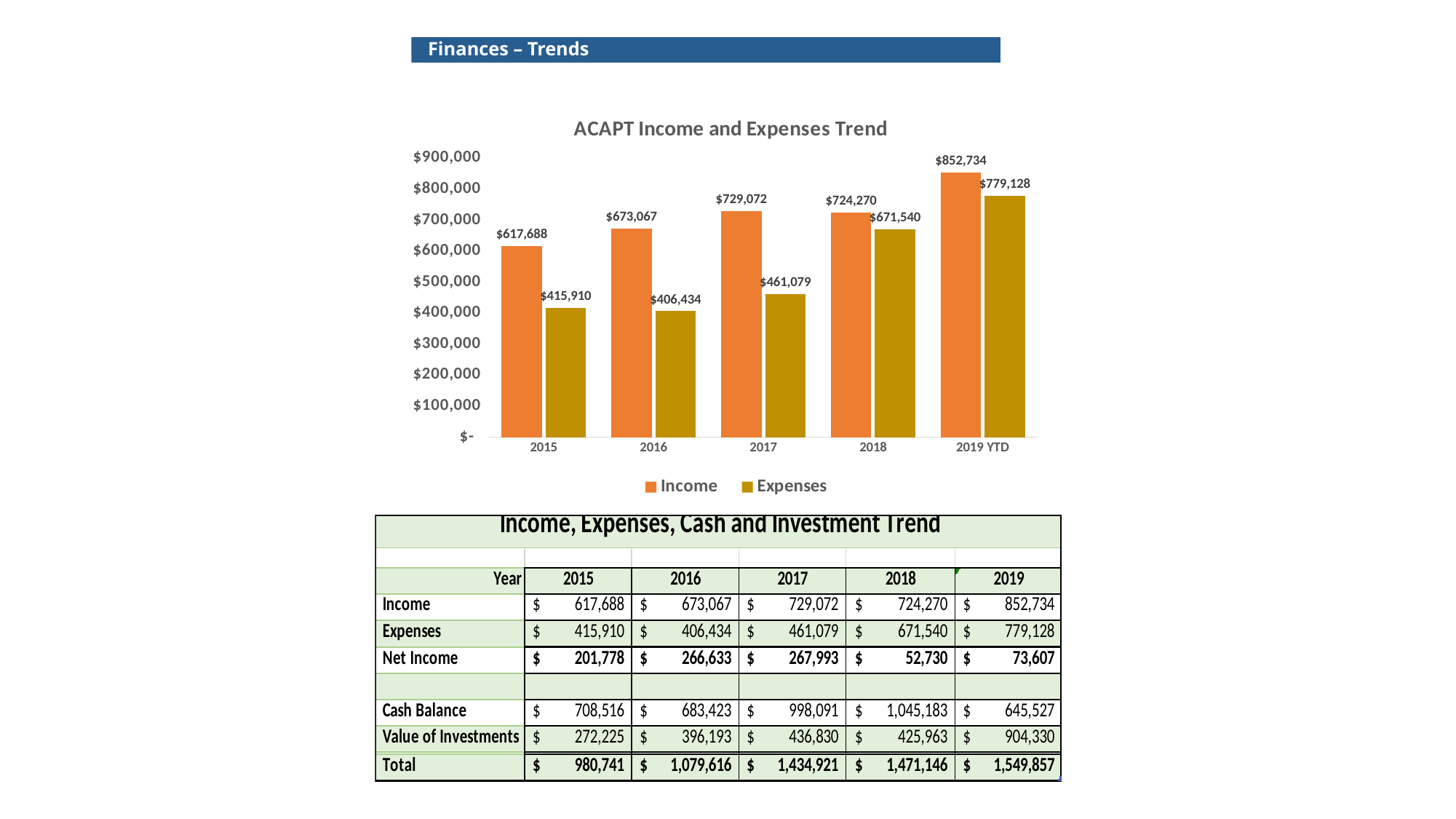
What is the title of the chart on the slide? ACAPT Income and Expenses Trend Is the Expenses value for 2018 greater or less than $600,000? greater How many years are shown on the x axis of the chart? 5 What kind of chart is the ACAPT Income and Expenses Trend chart? Bar chart What is the Income value for 2017 in the ACAPT Income and Expenses Trend chart? $729,072 Which year has the lowest Expenses in the chart? 2016 Which year has the highest Income in the chart? 2019 YTD What is the Expenses value for 2016 in the chart? $406,434 What is the Expenses value for 2019 YTD in the chart? $779,128 Which is larger in the chart, Income for 2017 or Income for 2018? Income for 2017 What is the difference between Income and Expenses for 2015 in the chart? $201,778 How many series does the chart's legend list? 2